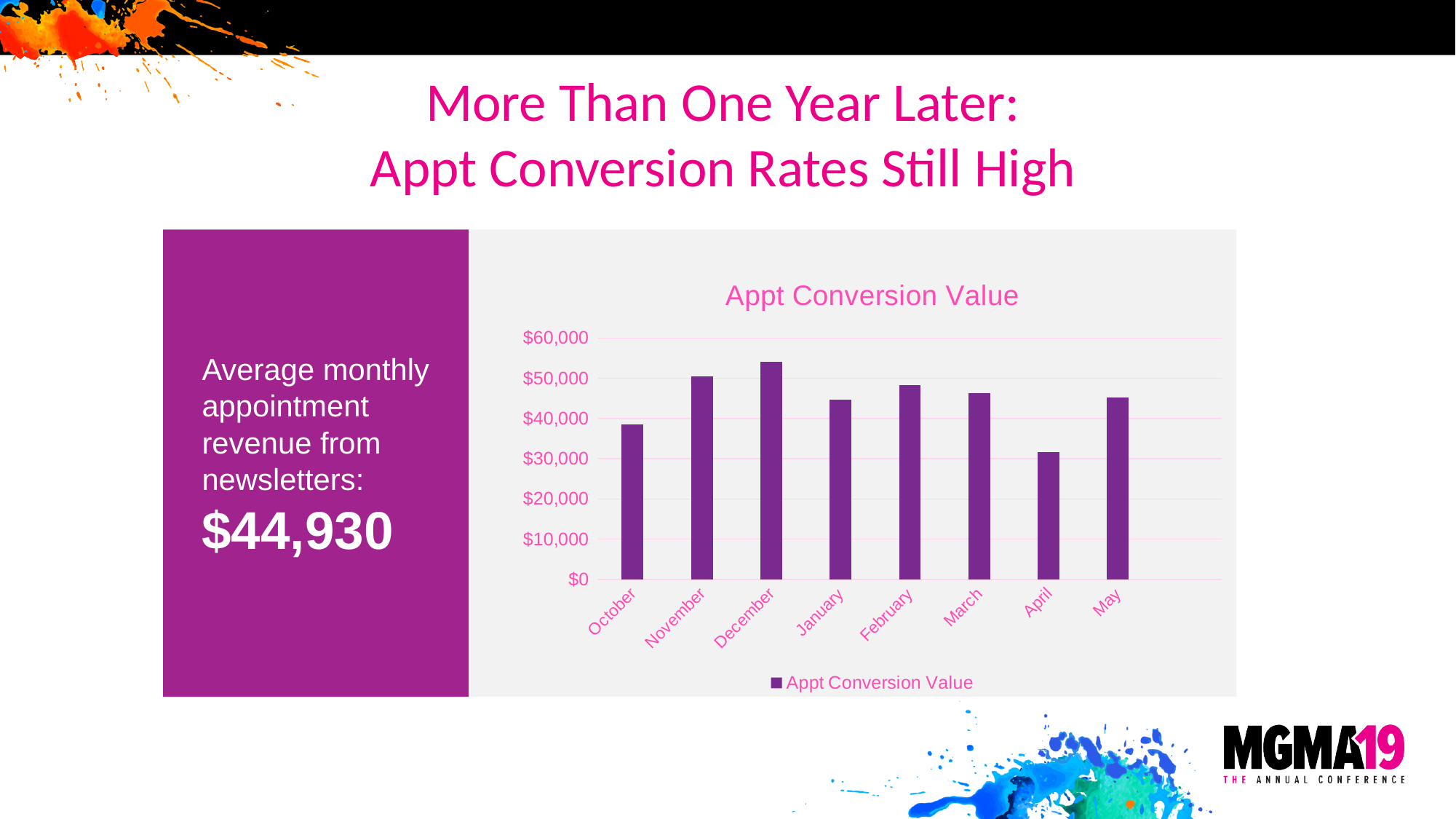
Is the Appt Conversion Value for December greater or less than $50,000? greater What kind of chart is shown on the slide? bar chart Is the Appt Conversion Value for October greater or less than $40,000? less Which month has a higher Appt Conversion Value, October or December? December Which month has a higher Appt Conversion Value, March or April? March Is the Appt Conversion Value for April greater or less than $40,000? less What is the title of the chart? Appt Conversion Value How many months are plotted on the x axis of the Appt Conversion Value chart? 8 Which month has the highest Appt Conversion Value? December Which month has the lowest Appt Conversion Value? April How many series does the legend of the chart list? 1